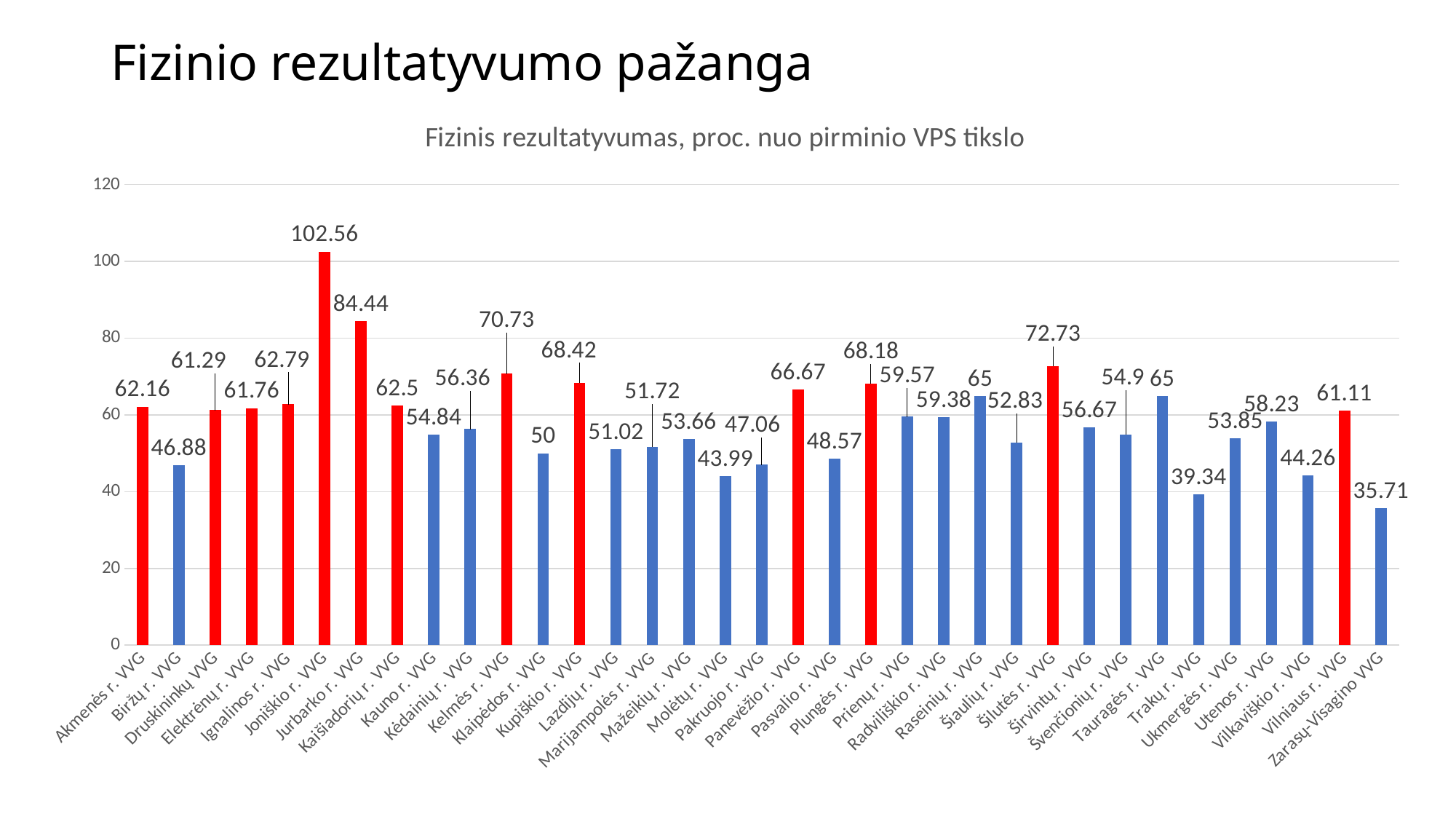
What is the value for Šilutės r. VVG? 72.73 Which category has the lowest value? Zarasų-Visagino VVG Which category has the highest value? Joniškio r. VVG What is the title of the chart? Fizinis rezultatyvumas, proc. nuo pirminio VPS tikslo What is the value for Klaipėdos r. VVG? 50 What kind of chart is shown on the slide? bar chart Is the value for Joniškio r. VVG greater or less than 100? greater What is the difference between the values for Joniškio r. VVG and Jurbarko r. VVG? 18.12 Which is larger, the value for Kelmės r. VVG or Kupiškio r. VVG? Kelmės r. VVG What is the value for Zarasų-Visagino VVG? 35.71 How many categories are shown on the x axis? 35 What is the value for Joniškio r. VVG? 102.56